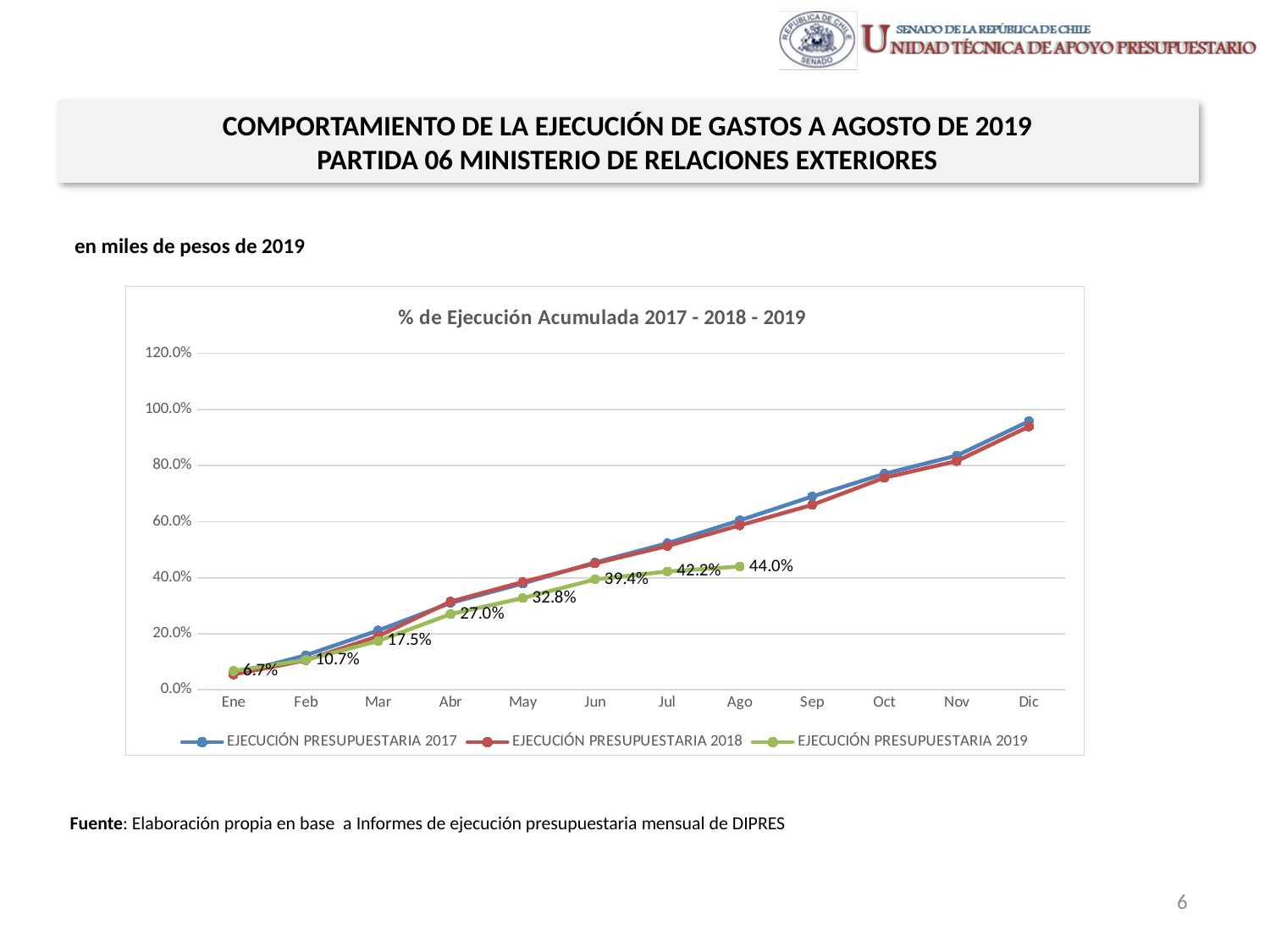
How many months are shown on the x axis of the chart? 12 Is the value for EJECUCIÓN PRESUPUESTARIA 2018 in Sep greater or less than 80.0%? less What is the title of the chart? % de Ejecución Acumulada 2017 - 2018 - 2019 What is the difference between the EJECUCIÓN PRESUPUESTARIA 2019 values for Ago and Jul? 1.8% Does the EJECUCIÓN PRESUPUESTARIA 2019 series rise or fall from Ene to Ago? Rise What is the value for EJECUCIÓN PRESUPUESTARIA 2019 in Abr? 27.0% What is the difference between the EJECUCIÓN PRESUPUESTARIA 2019 values for Jun and May? 6.6% What kind of chart is shown on the slide? Line chart What is the value for EJECUCIÓN PRESUPUESTARIA 2019 in Ago? 44.0% Is the value for EJECUCIÓN PRESUPUESTARIA 2017 in Dic greater or less than 80.0%? greater How many series does the chart legend list? 3 What is the value for EJECUCIÓN PRESUPUESTARIA 2019 in Ene? 6.7%